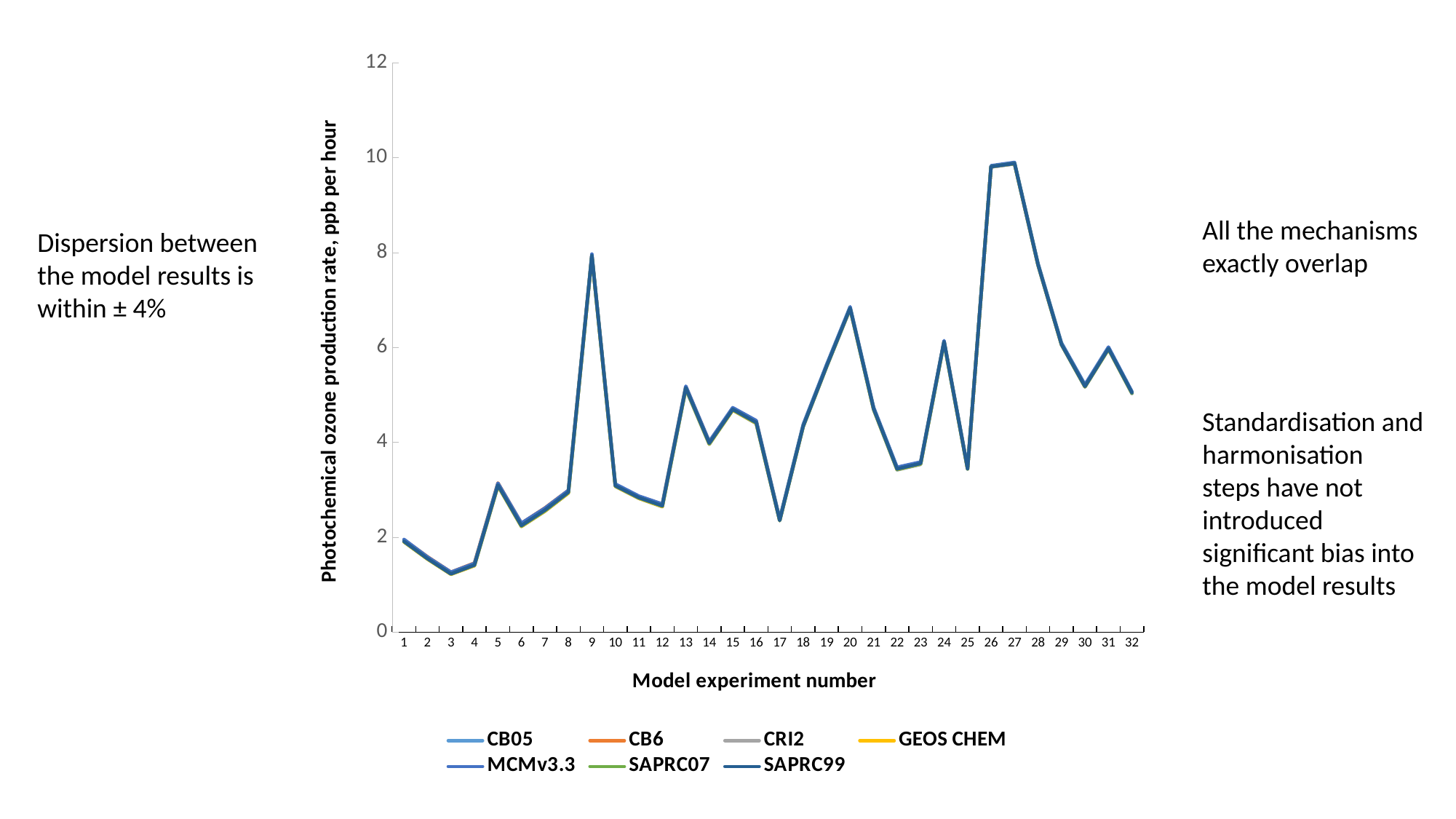
Which has the larger value, model experiment 9 or model experiment 20? model experiment 9 Is the value for model experiment 20 greater or less than 6? greater Is the value for model experiment 13 greater or less than 4? greater How many model experiment numbers are shown along the x axis? 32 What is the title of the x axis? Model experiment number Which model experiment number has the lowest photochemical ozone production rate? 3 What kind of chart is shown on the slide? line chart How many series does the legend list? 7 Is the value for model experiment 25 greater or less than 4? less What is the title of the y axis? Photochemical ozone production rate, ppb per hour Do the values rise or fall from model experiment 27 to model experiment 30? fall